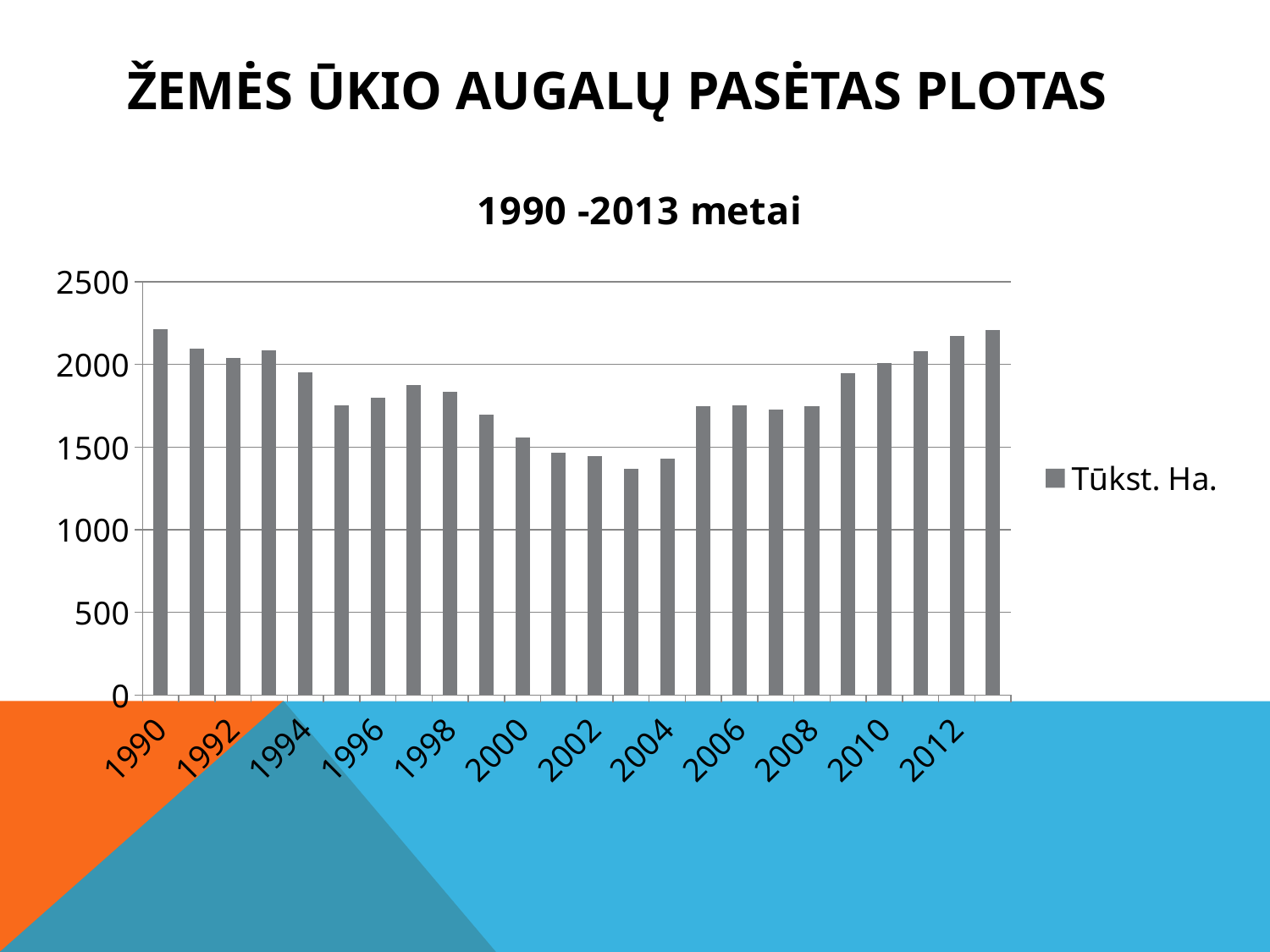
What kind of chart is shown on the slide? bar chart How many bars (years) are plotted in the chart? 24 Which is larger, the value for 1999 or the value for 2000? 1999 What is the legend entry for the series? Tūkst. Ha. Is the value for 2003 greater or less than 1500? less Which year has the lowest value? 2003 Is the value for 1995 greater or less than 2000? less How many series does the legend list? 1 Do the values rise or fall from 2003 to 2013? rise What is the title of the chart? 1990 -2013 metai Is the value for 1990 greater or less than 2000? greater